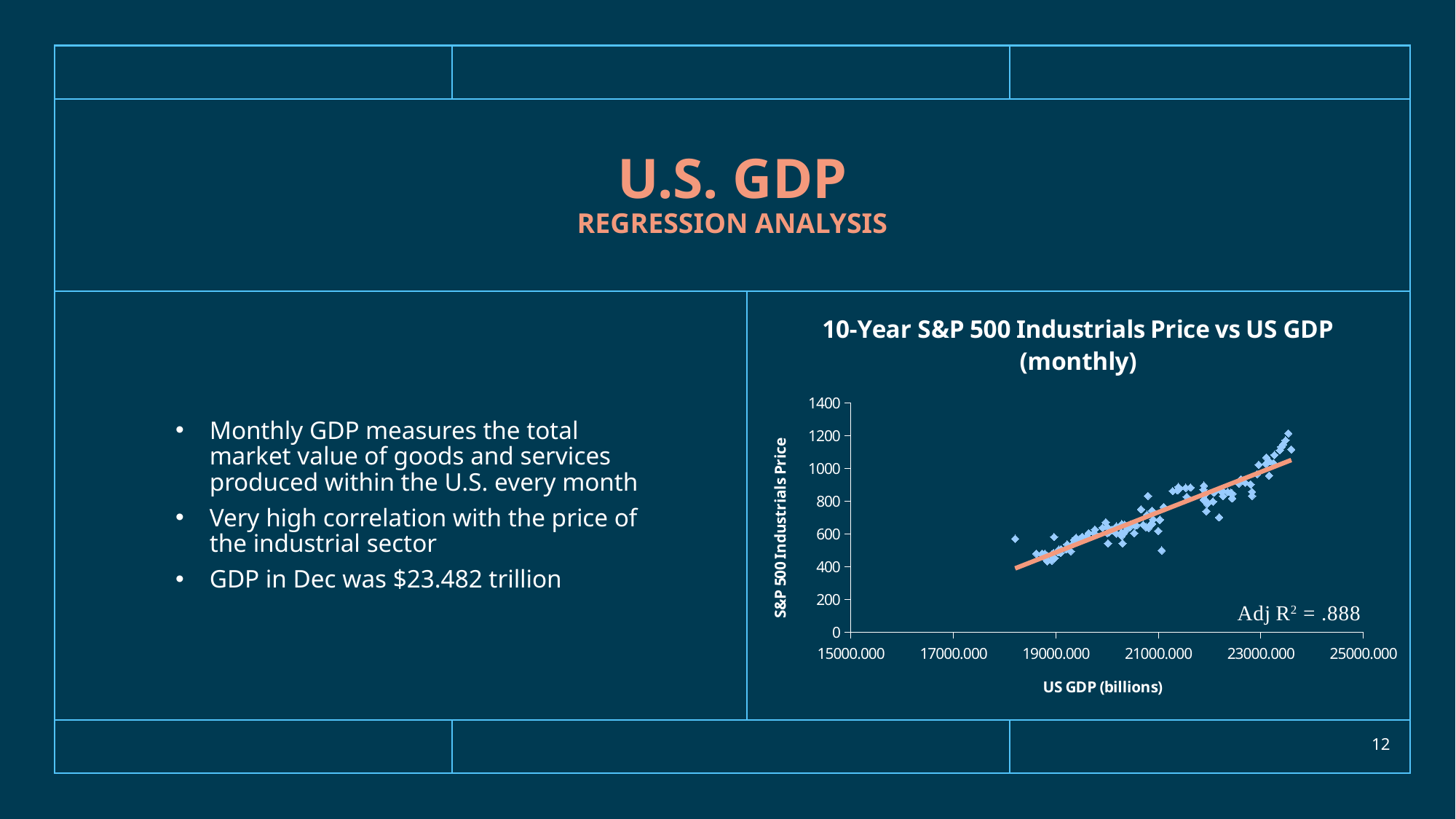
Is the lowest plotted S&P 500 Industrials Price greater or less than 600? less What is the title of the chart? 10-Year S&P 500 Industrials Price vs US GDP (monthly) Is the highest plotted S&P 500 Industrials Price greater or less than 1000? greater What is the highest tick value shown on the y axis of the chart? 1400 What kind of chart is shown on the slide? Scatter chart As US GDP increases along the x axis, do the plotted S&P 500 Industrials prices generally rise or fall? Rise What Adj R² value is printed on the chart? .888 What is the highest tick value shown on the x axis of the chart? 25000.000 At a US GDP of about 19000 billion, does the trend line lie above or below 600 on the price axis? below Are the plotted prices at a US GDP of about 23000 billion higher or lower than those at about 19000 billion? higher